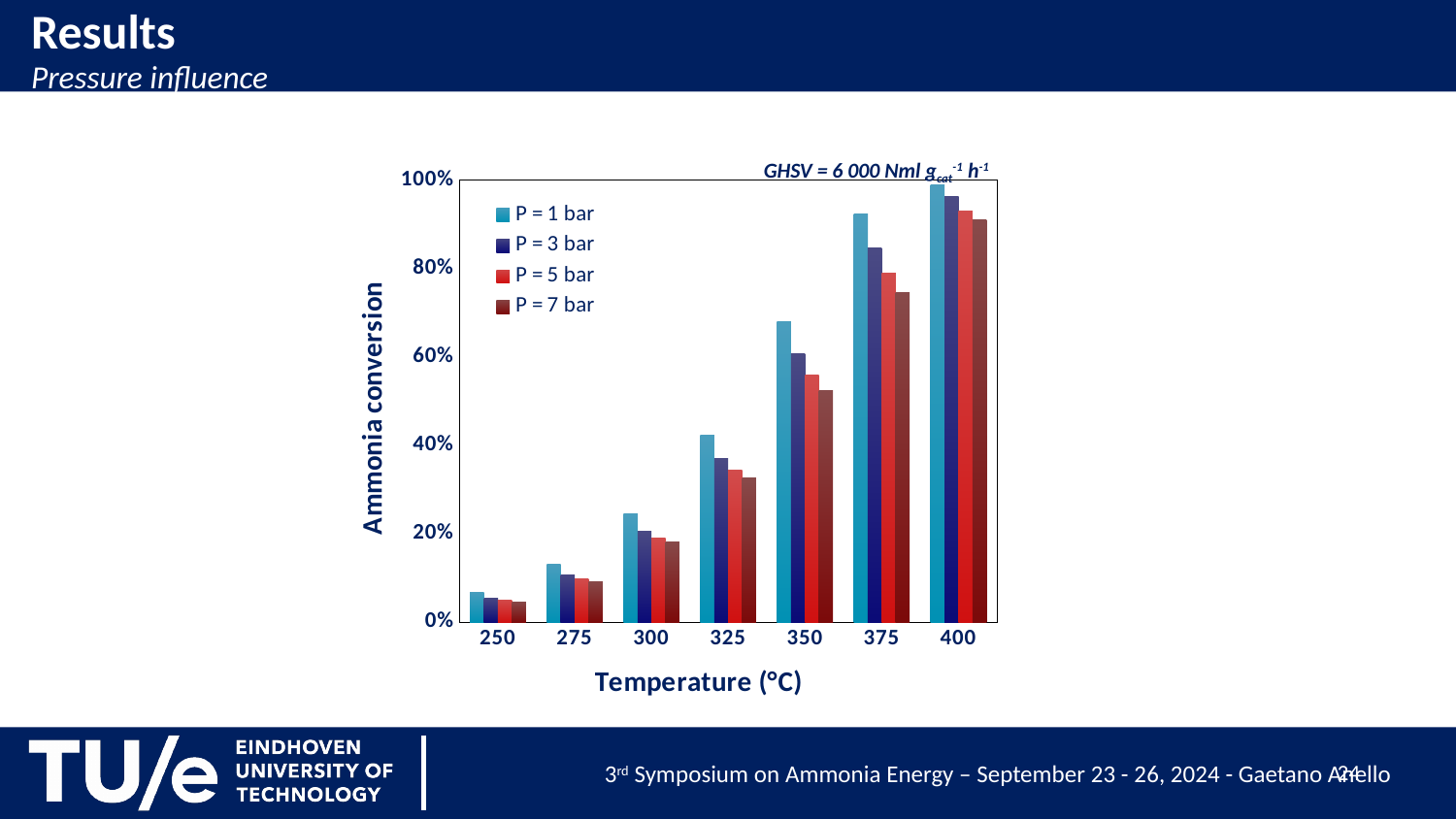
Is the ammonia conversion for P = 7 bar at 300 °C greater or less than 20%? less Is the ammonia conversion for P = 7 bar at 375 °C greater or less than 80%? less At 350 °C, which is larger: the ammonia conversion for P = 1 bar or for P = 7 bar? P = 1 bar Does ammonia conversion rise or fall as temperature increases along the x axis? rise At which temperature is the ammonia conversion for P = 1 bar lowest? 250 What is the label of the x axis? Temperature (°C) What is the label of the y axis? Ammonia conversion What kind of chart is shown on the slide? bar chart Is the ammonia conversion for P = 1 bar at 350 °C greater or less than 60%? greater At 350 °C, which pressure series has the highest ammonia conversion? P = 1 bar How many pressure series does the legend list? 4 How many temperature categories are shown on the x axis? 7